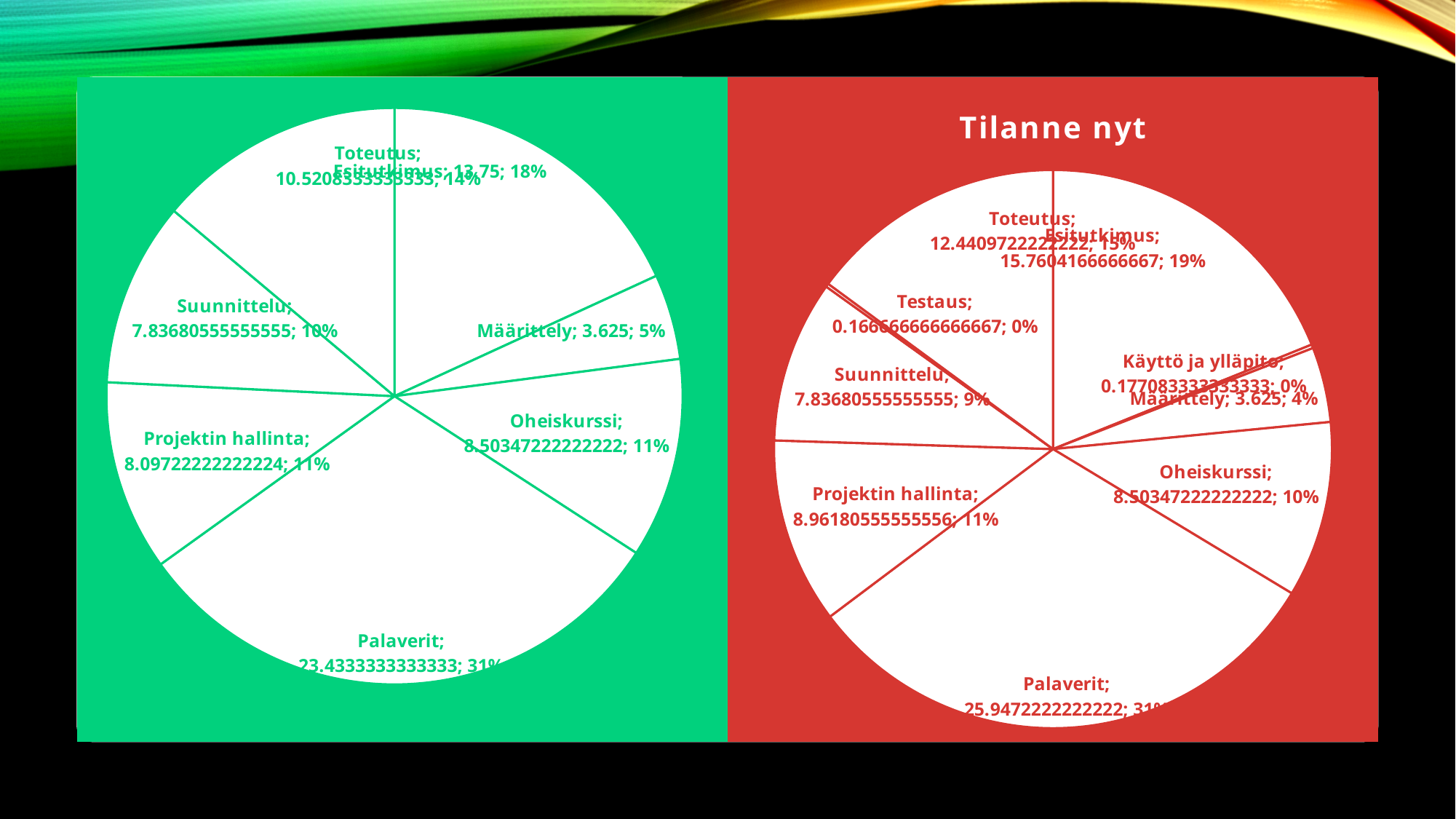
What type of chart is shown on the right side of the slide under the title "Tilanne nyt"? pie chart In the left (green) pie chart, how many categories are shown? 7 In the "Tilanne nyt" chart, how many categories are shown? 9 In the left (green) pie chart, what is the value shown for Palaverit? 23.4333333333333 In the left (green) pie chart, what percentage share does Määrittely have? 5% In the "Tilanne nyt" chart, what is the value shown for Esitutkimus? 15.7604166666667 In the left (green) pie chart, which category has the largest slice? Palaverit In the "Tilanne nyt" chart, what is the value shown for Testaus? 0.166666666666667 In the "Tilanne nyt" chart, which is larger, Oheiskurssi or Suunnittelu? Oheiskurssi In the "Tilanne nyt" chart, what percentage share does Palaverit have? 31% What is the title of the chart on the right side of the slide? Tilanne nyt In the "Tilanne nyt" chart, which category has the largest slice? Palaverit